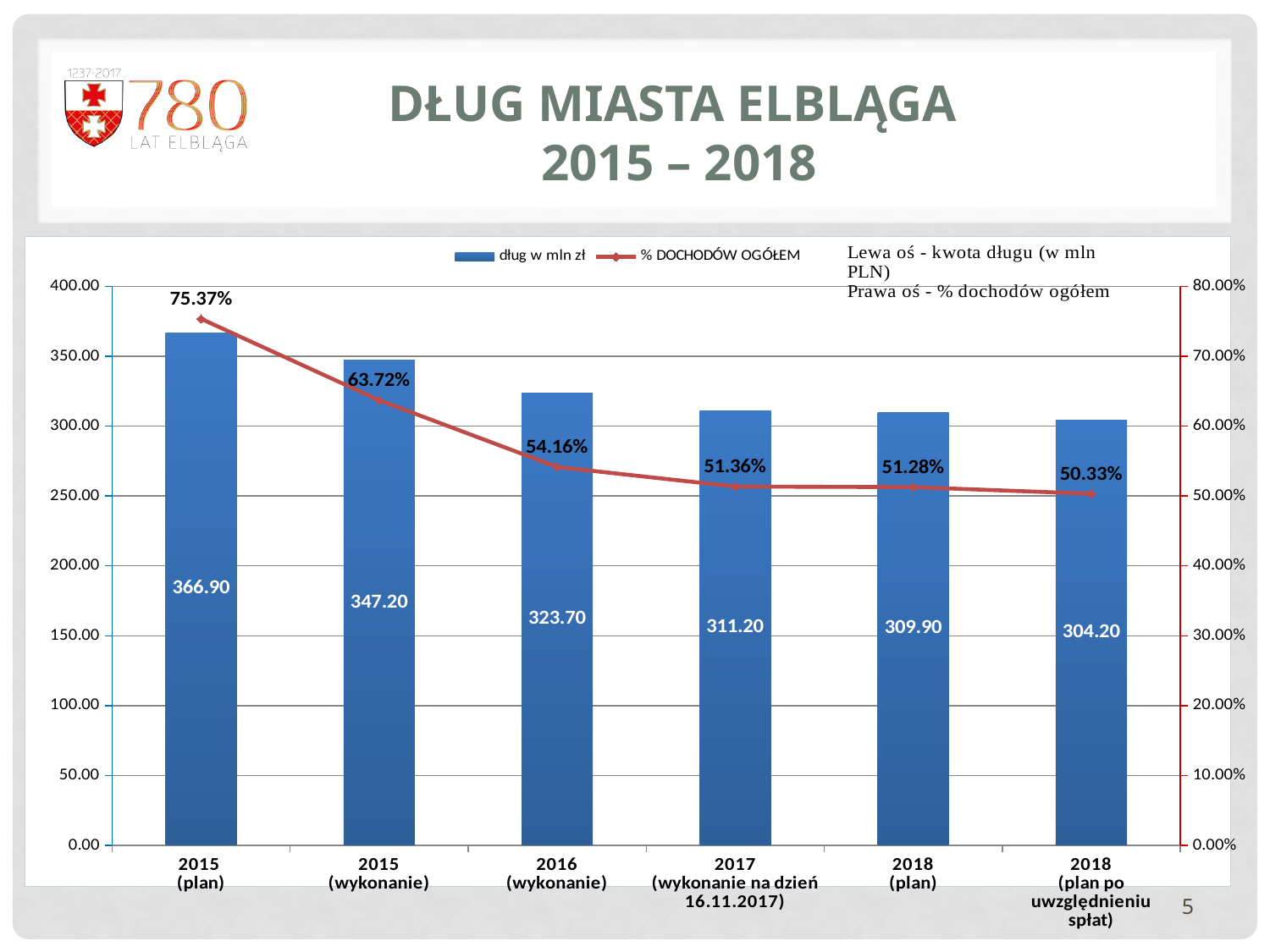
What is the debt in mln zł for 2018 (plan po uwzględnieniu spłat)? 304.20 What kind of chart is used for the 'dług w mln zł' series? bar chart What is the difference in debt (mln zł) between 2015 (plan) and 2015 (wykonanie)? 19.70 Which category has the highest debt in mln zł? 2015 (plan) What is the title of the chart? DŁUG MIASTA ELBLĄGA 2015 – 2018 How many series does the legend list? 2 What is the debt in mln zł for 2015 (plan)? 366.90 Do the % DOCHODÓW OGÓŁEM values rise or fall from left to right along the x axis? fall What is the % DOCHODÓW OGÓŁEM value for 2016 (wykonanie)? 54.16% How many categories are shown on the x axis? 6 Which is larger: the debt for 2017 (wykonanie na dzień 16.11.2017) or for 2018 (plan)? 2017 (wykonanie na dzień 16.11.2017) Which category has the lowest % DOCHODÓW OGÓŁEM value? 2018 (plan po uwzględnieniu spłat)